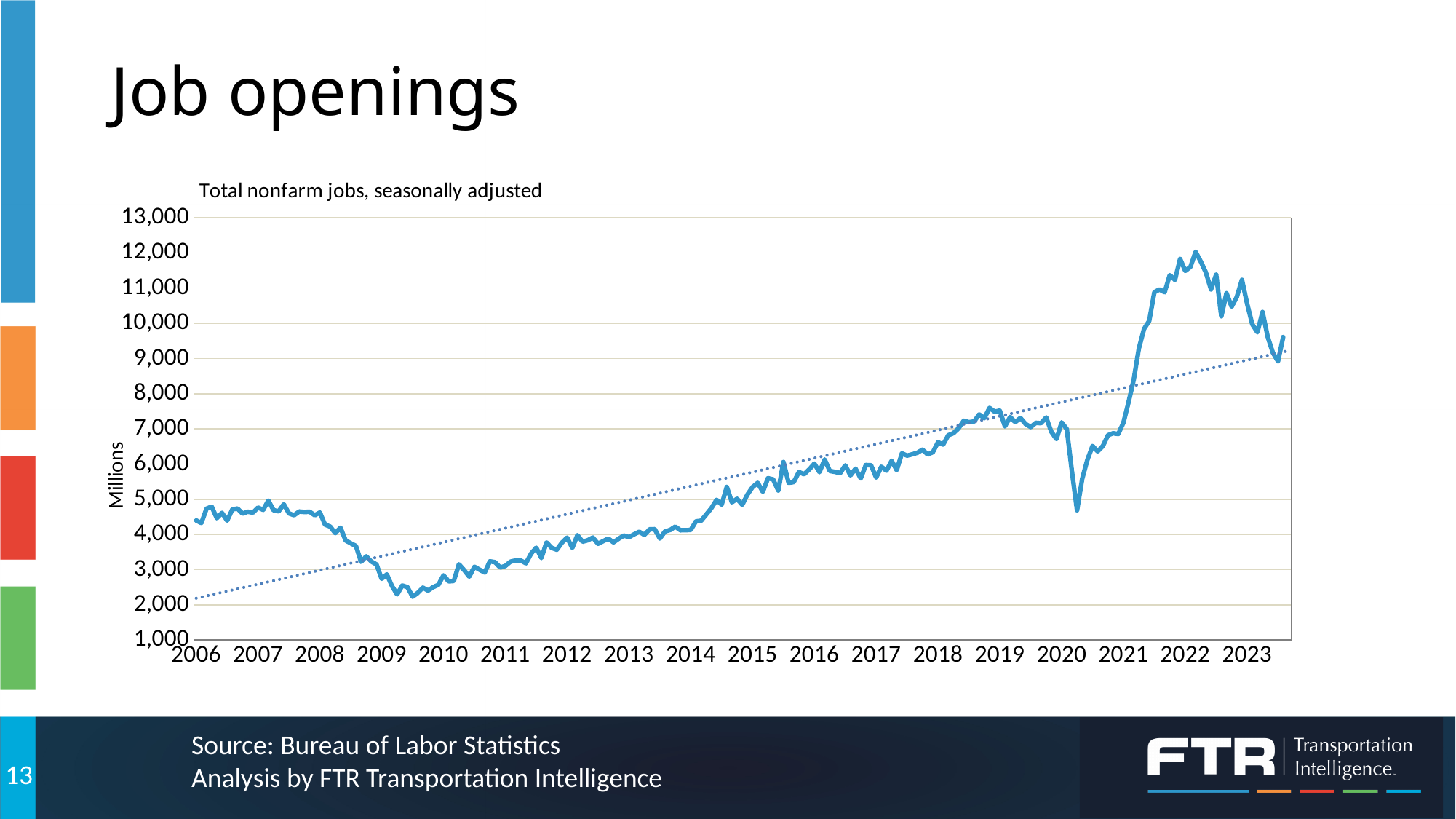
What kind of chart is shown on the slide? line chart Is the value at the sharp dip in 2020 greater or less than 6,000? less Is the peak value reached in 2022 greater or less than 11,000? greater Which is higher: the peak in 2007 or the peak in 2022? the peak in 2022 What is the label on the vertical axis of the chart? Millions How many years are labeled on the horizontal axis? 18 Overall, does the line rise or fall from 2006 to 2023? rise In which year does the line reach its lowest value? 2009 What is the title of the chart? Total nonfarm jobs, seasonally adjusted In which year does the line reach its highest value? 2022 Is the lowest value reached in 2009 greater or less than 3,000? less